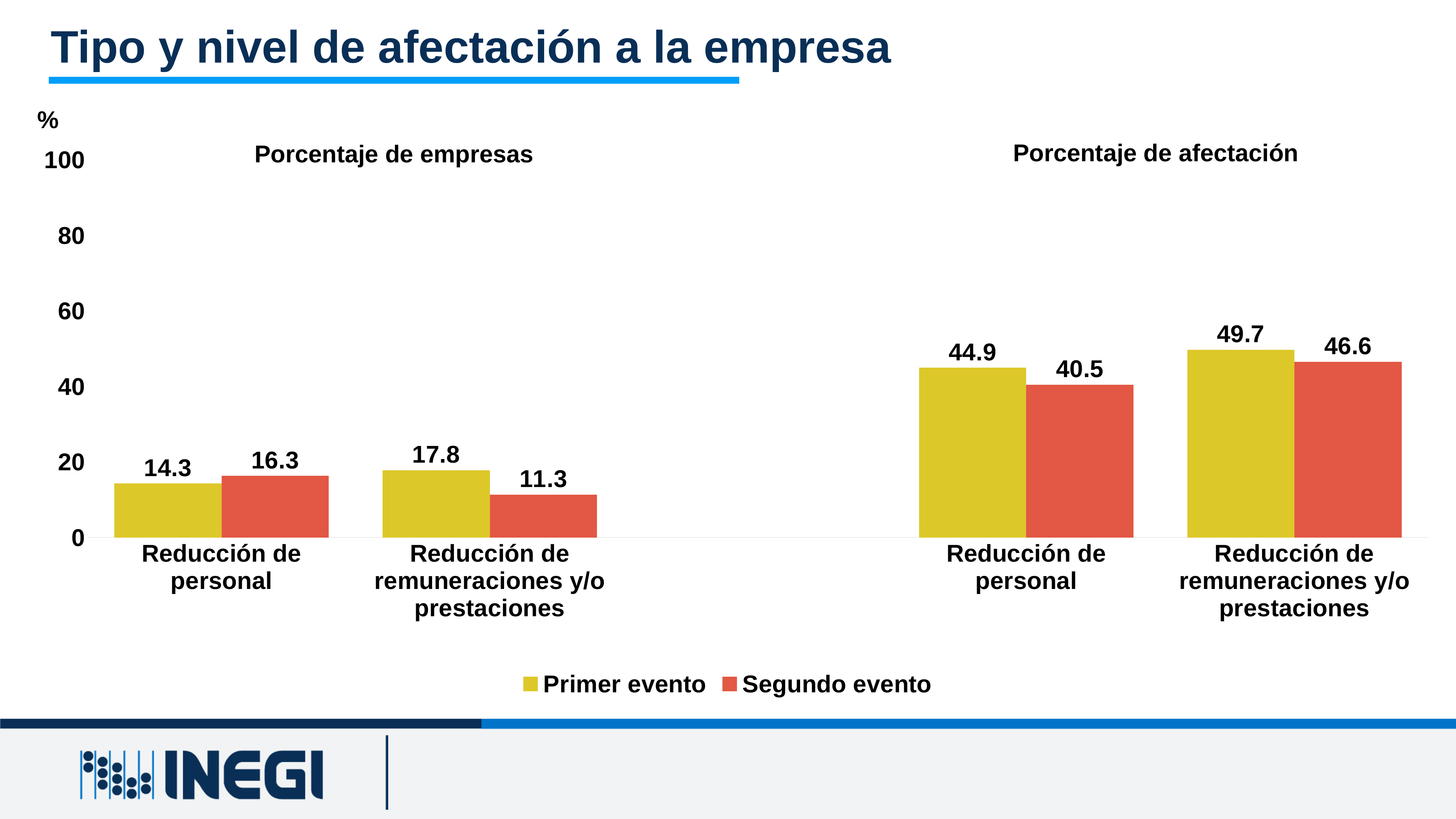
In the 'Porcentaje de afectación' section, what is the value for Segundo evento for Reducción de personal? 40.5 Which bar on the slide has the highest value? Primer evento, Reducción de remuneraciones y/o prestaciones (Porcentaje de afectación) What kind of chart is shown on the slide? Bar chart What colour represents Segundo evento in the legend? Red In the 'Porcentaje de empresas' section, what is the value for Primer evento for Reducción de personal? 14.3 In the 'Porcentaje de empresas' section, what is the difference between Primer evento and Segundo evento for Reducción de remuneraciones y/o prestaciones? 6.5 Which bar on the slide has the lowest value? Segundo evento, Reducción de remuneraciones y/o prestaciones (Porcentaje de empresas) How many series does the legend list? 2 In the 'Porcentaje de empresas' section, for Reducción de personal, which is larger: Primer evento or Segundo evento? Segundo evento In the 'Porcentaje de afectación' section, what is the value for Primer evento for Reducción de remuneraciones y/o prestaciones? 49.7 In the 'Porcentaje de afectación' section, what is the difference between Primer evento and Segundo evento for Reducción de personal? 4.4 In the 'Porcentaje de empresas' section, what is the value for Segundo evento for Reducción de remuneraciones y/o prestaciones? 11.3